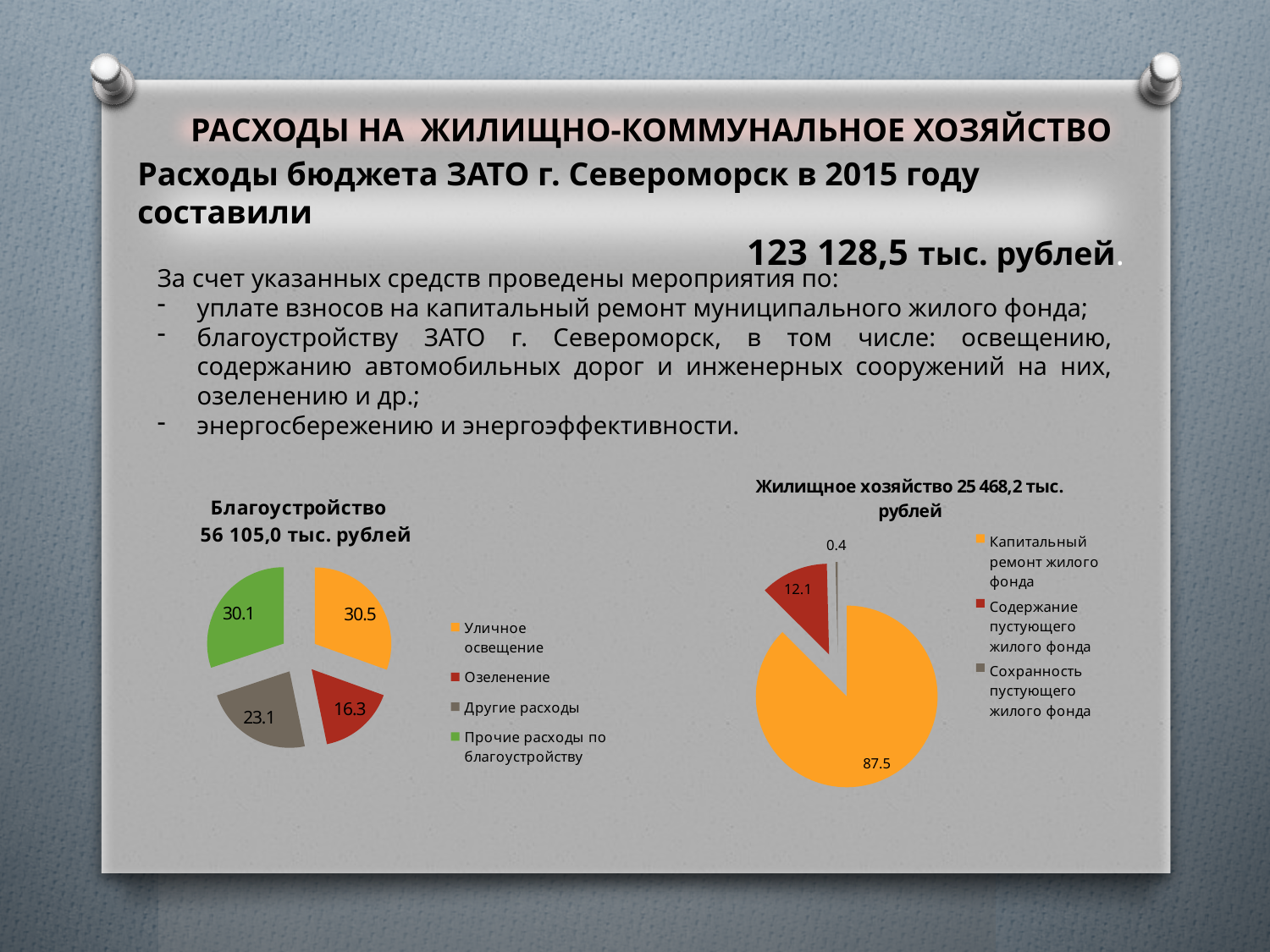
In the right pie chart (Жилищное хозяйство), which category has the largest slice? Капитальный ремонт жилого фонда In the left pie chart (Благоустройство), what is the value for Уличное освещение? 30.5 In the left pie chart (Благоустройство), how many slices does the pie have? 4 In the right pie chart (Жилищное хозяйство), how many entries does the legend list? 3 In the right pie chart (Жилищное хозяйство), which is larger: Содержание пустующего жилого фонда or Сохранность пустующего жилого фонда? Содержание пустующего жилого фонда In the right pie chart (Жилищное хозяйство), what is the value for Содержание пустующего жилого фонда? 12.1 In the left pie chart (Благоустройство), what is the value for Озеленение? 16.3 In the left pie chart (Благоустройство), what is the value for Другие расходы? 23.1 In the right pie chart (Жилищное хозяйство), what is the value for Капитальный ремонт жилого фонда? 87.5 In the left pie chart (Благоустройство), what is the difference between the values for Уличное освещение and Озеленение? 14.2 What type of chart is the left chart (Благоустройство)? Pie chart In the left pie chart (Благоустройство), which category has the smallest slice? Озеленение